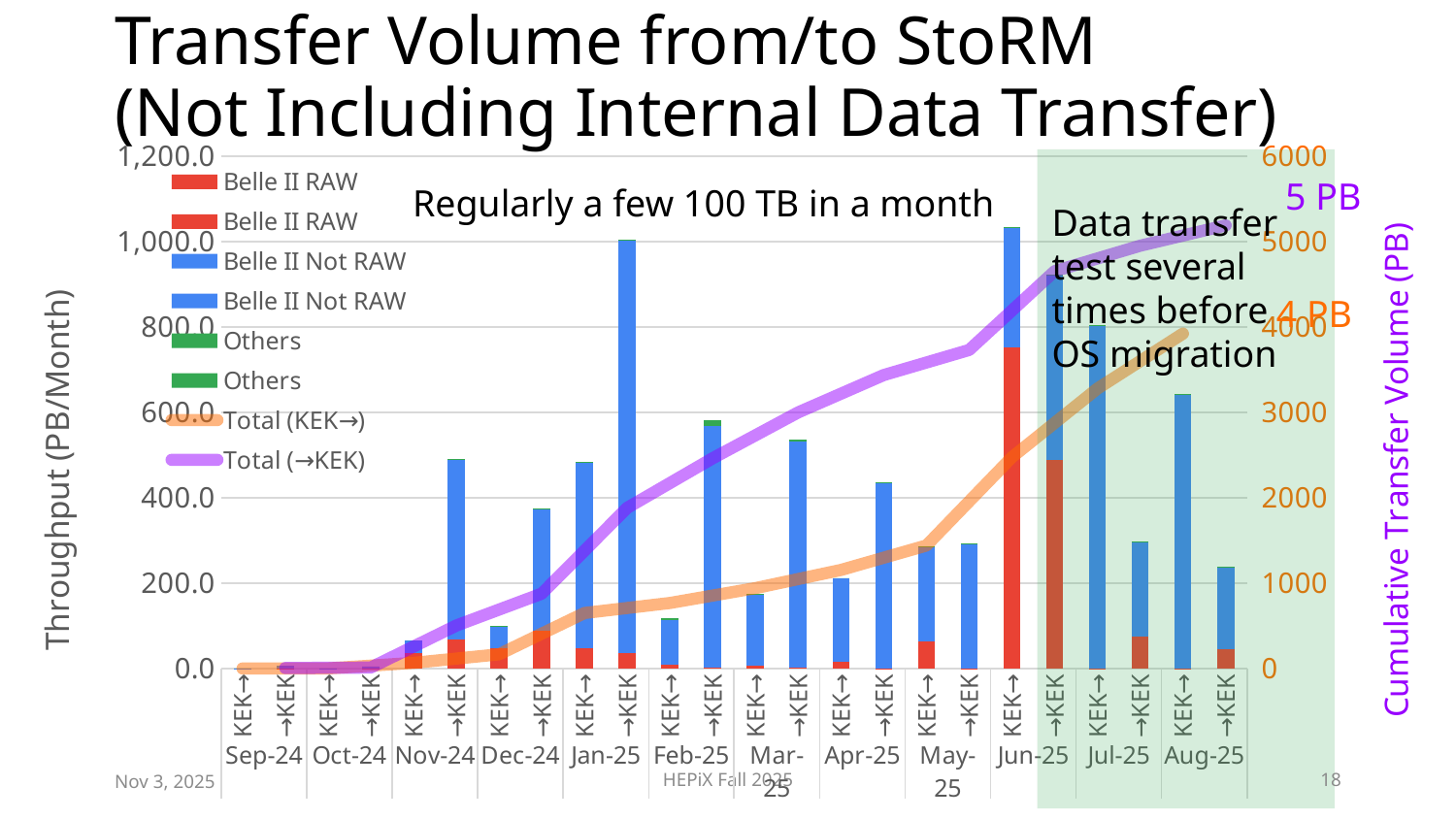
How many months are shown along the x axis of the chart? 12 What kind of chart is shown on the slide? A combined bar and line chart (stacked bars with two line series) How many entries does the chart legend list? 8 Which month has the tallest KEK→ bar? Jun-25 In Jan-25, which bar is taller: KEK→ or →KEK? →KEK What is the label of the right-hand vertical axis? Cumulative Transfer Volume (PB) Does the Total (→KEK) line rise or fall from Sep-24 to Aug-25? rise What cumulative value is annotated at the end of the Total (→KEK) line? 5 PB In Jun-25, which bar is taller: KEK→ or →KEK? KEK→ Is the KEK→ bar for Jun-25 greater or less than 800? greater Which month has the tallest →KEK bar? Jan-25 Is the →KEK bar for Nov-24 greater or less than 600? less